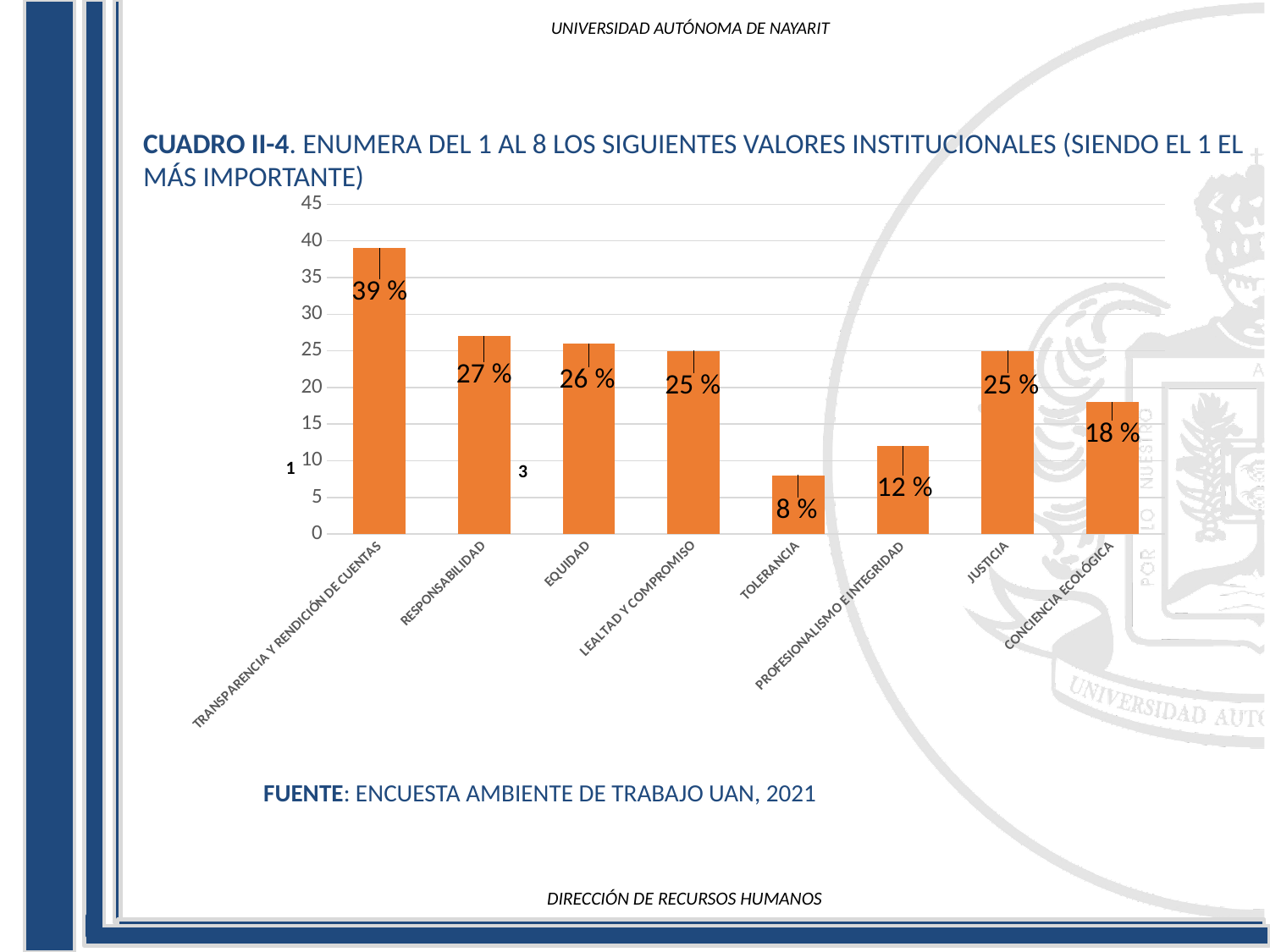
Which is larger, the value for JUSTICIA or the value for CONCIENCIA ECOLÓGICA? JUSTICIA Which category has the lowest value? TOLERANCIA What kind of chart is shown on the slide? bar chart How many categories are shown on the x axis? 8 Which category has the highest value? TRANSPARENCIA Y RENDICIÓN DE CUENTAS Is the value for RESPONSABILIDAD greater or less than 25? greater What is the difference between the values for RESPONSABILIDAD and EQUIDAD? 1 % What is the value for PROFESIONALISMO E INTEGRIDAD? 12 % What is the value for TOLERANCIA? 8 % What is the difference between the values for TRANSPARENCIA Y RENDICIÓN DE CUENTAS and TOLERANCIA? 31 % What is the value for TRANSPARENCIA Y RENDICIÓN DE CUENTAS? 39 % What is the value for CONCIENCIA ECOLÓGICA? 18 %